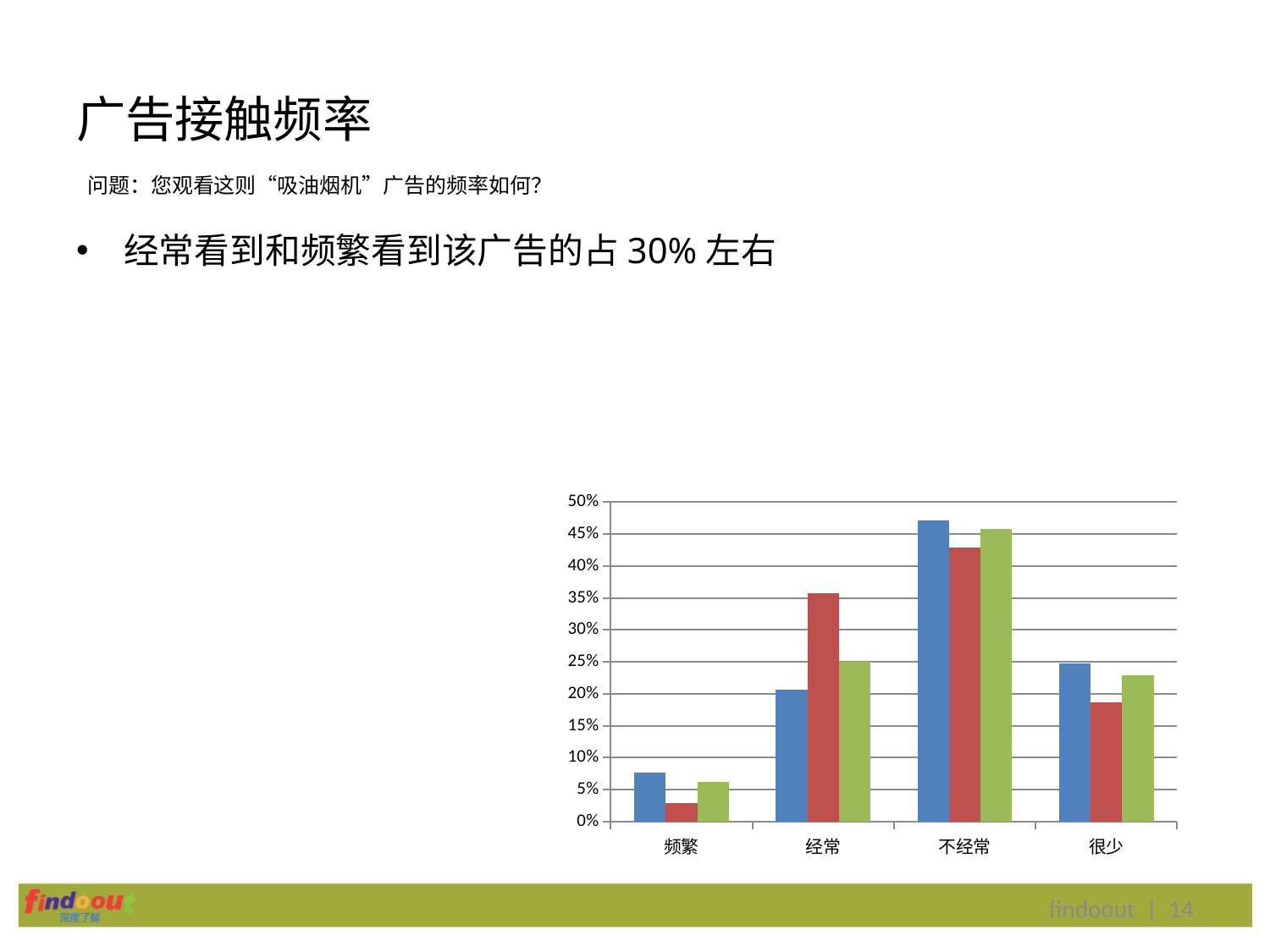
Is the value of the red bar for 频繁 greater or less than 5%? less How many categories are shown on the x axis of the chart? 4 Is the value of the blue bar for 很少 greater or less than 30%? less For the category 经常, which bar is taller, the blue bar or the red bar? the red bar What kind of chart is shown on the slide? bar chart Is the value of the red bar for 经常 greater or less than 30%? greater How many bars are plotted for each category in the chart? 3 What is the highest value shown on the y axis of the chart? 50% Which category has the shortest bars in the chart? 频繁 Which category has the tallest bars in the chart? 不经常 For the category 很少, which bar is taller, the blue bar or the red bar? the blue bar